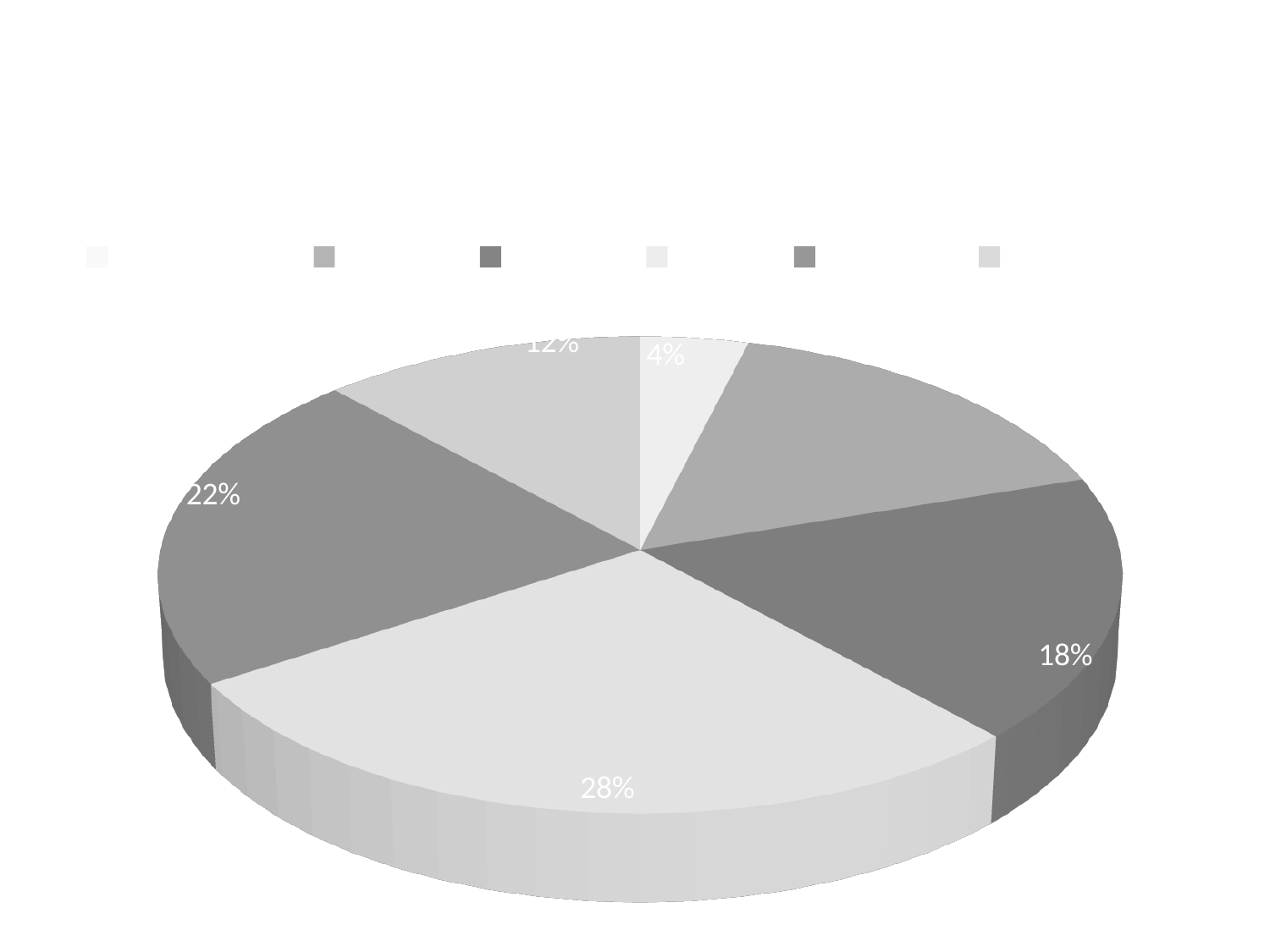
Which is larger in the pie chart: the slice on the left side or the slice on the right side? the slice on the left side (22%) How many entries does the legend of the pie chart show? 6 What is the difference between the largest slice (28%) and the smallest slice (4%) in the pie chart? 24% How many slices of the pie chart have a percentage label printed on them? 5 How many slices does the pie chart have? 6 What is the value of the smallest slice in the pie chart? 4% What is the difference between the 22% slice and the 18% slice in the pie chart? 4% What is the difference between the 28% slice and the 22% slice in the pie chart? 6% What is the value of the largest slice in the pie chart? 28% What value is printed on the slice at the bottom of the pie chart? 28% What kind of chart is shown on the slide? pie chart What value is printed on the slice on the right side of the pie chart? 18%